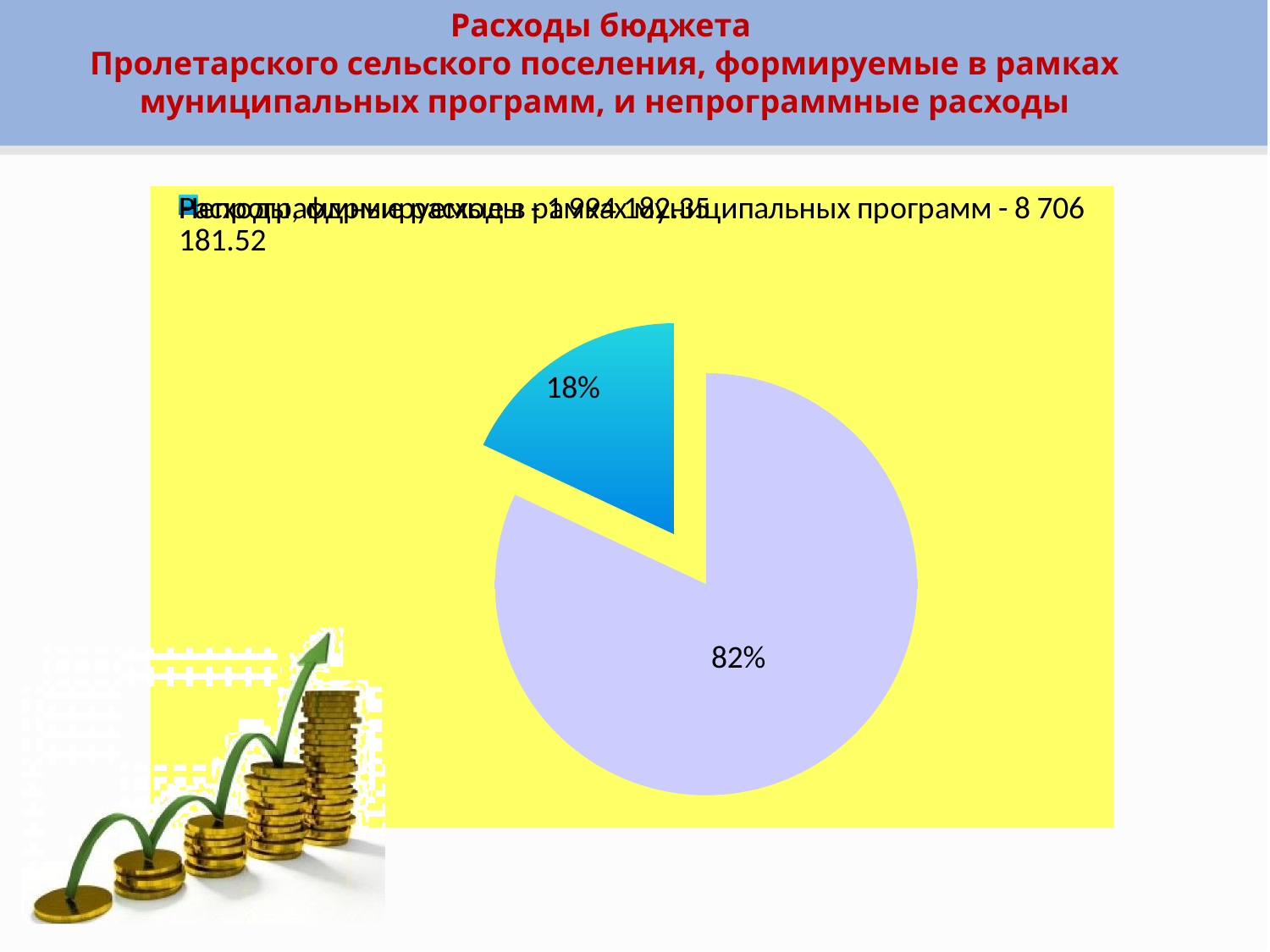
What kind of chart is shown on the slide? pie chart Which slice is larger, the light purple one or the blue one? the light purple one What percentage is shown on the smallest slice of the pie chart? 18% What share of the pie does the light purple slice represent? 82% What colour is the slice labelled 82%? light purple By how many percentage points does the larger slice exceed the smaller slice? 64 What percentage is shown on the largest slice of the pie chart? 82% How many slices does the pie chart have? 2 What share of the pie does the blue slice represent? 18% What colour is the slice labelled 18%? blue Is the share of the blue slice greater or less than 50%? less